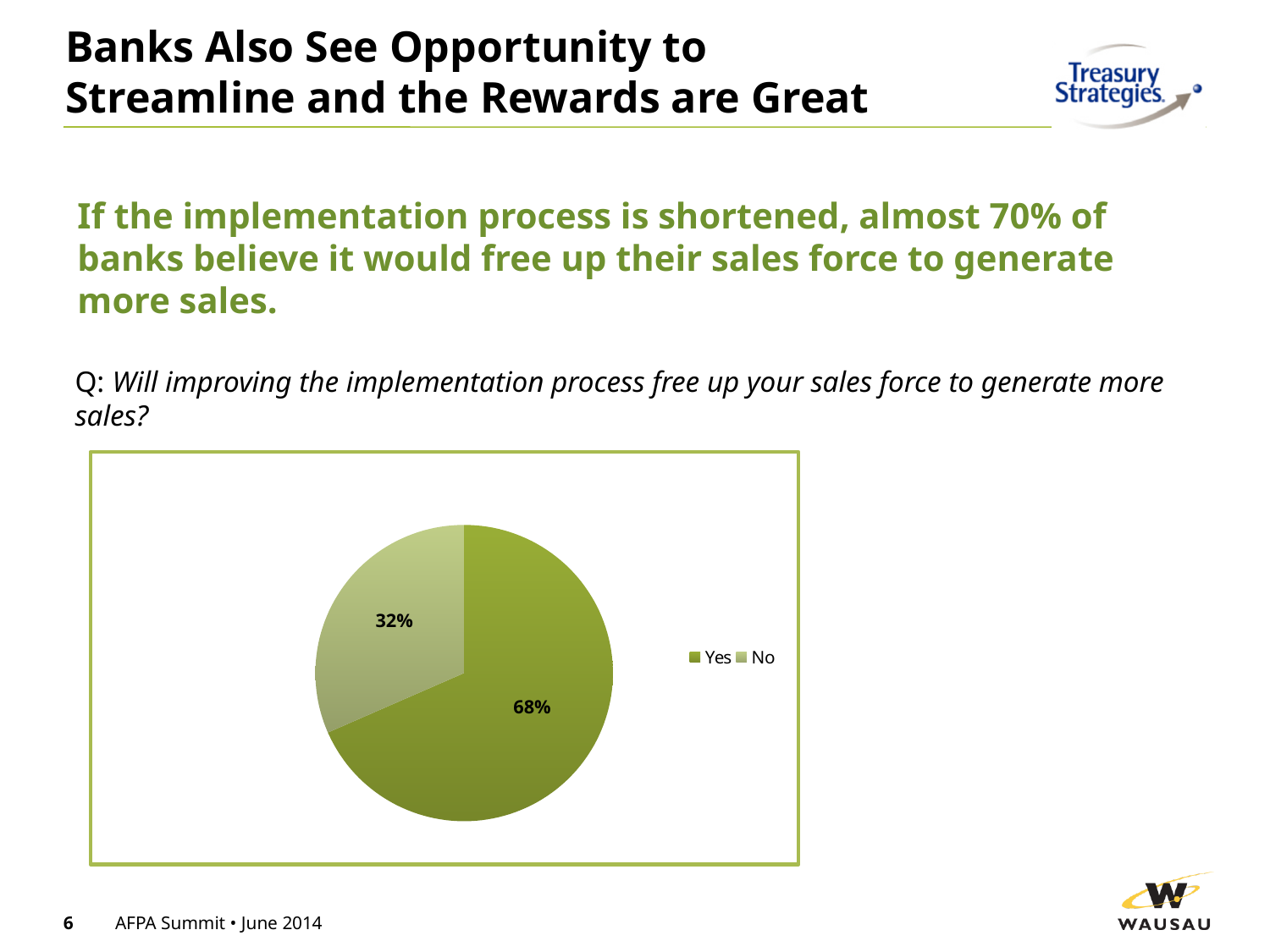
Which is larger, the "Yes" slice or the "No" slice? Yes What is the total of the two slice percentages shown on the pie chart? 100% How many slices does the pie chart have? 2 What kind of chart is shown on the slide? pie chart What is the difference in percentage points between the "Yes" and "No" slices? 36 What are the two legend entries of the pie chart? Yes and No What share of the pie is labelled "No"? 32% What share of the pie is labelled "Yes"? 68% How many entries does the legend list? 2 Which slice of the pie is the smallest? No Which slice of the pie is the largest? Yes Which legend entry is shown in the darker green colour? Yes